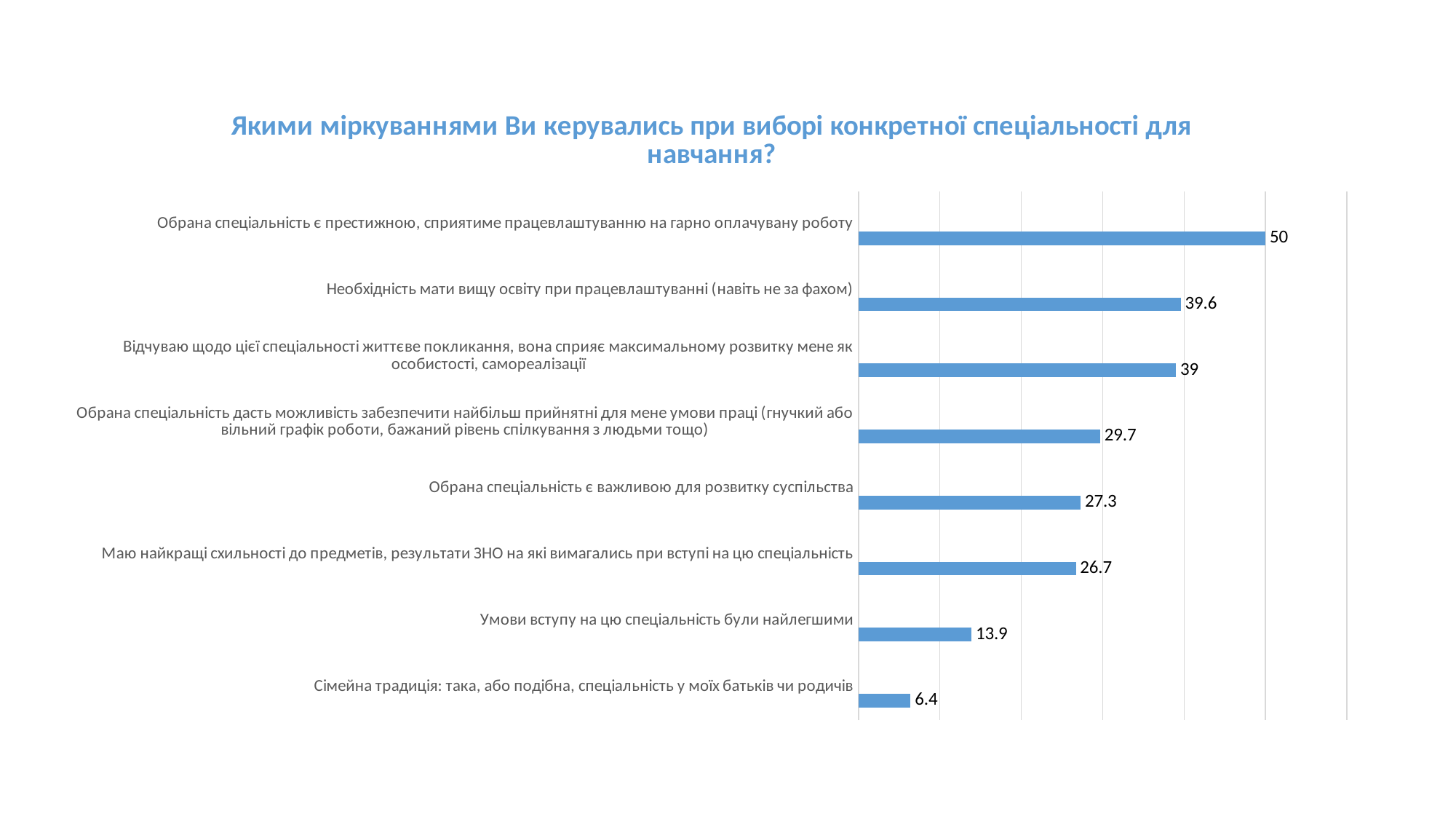
What is the title of the chart? Якими міркуваннями Ви керувались при виборі конкретної спеціальності для навчання? What kind of chart is shown on the slide? Bar chart How many categories are shown in the chart? 8 What is the value for "Обрана спеціальність є престижною, сприятиме працевлаштуванню на гарно оплачувану роботу"? 50 Which category has the lowest value? Сімейна традиція: така, або подібна, спеціальність у моїх батьків чи родичів What is the value for "Обрана спеціальність є важливою для розвитку суспільства"? 27.3 What is the difference between the value for "Обрана спеціальність є престижною, сприятиме працевлаштуванню на гарно оплачувану роботу" and the value for "Сімейна традиція: така, або подібна, спеціальність у моїх батьків чи родичів"? 43.6 What is the difference between the value for "Необхідність мати вищу освіту при працевлаштуванні (навіть не за фахом)" and the value for "Умови вступу на цю спеціальність були найлегшими"? 25.7 Which category has the highest value? Обрана спеціальність є престижною, сприятиме працевлаштуванню на гарно оплачувану роботу What is the value for "Необхідність мати вищу освіту при працевлаштуванні (навіть не за фахом)"? 39.6 Which is larger: the value for "Обрана спеціальність є важливою для розвитку суспільства" or the value for "Умови вступу на цю спеціальність були найлегшими"? Обрана спеціальність є важливою для розвитку суспільства What is the value for "Умови вступу на цю спеціальність були найлегшими"? 13.9